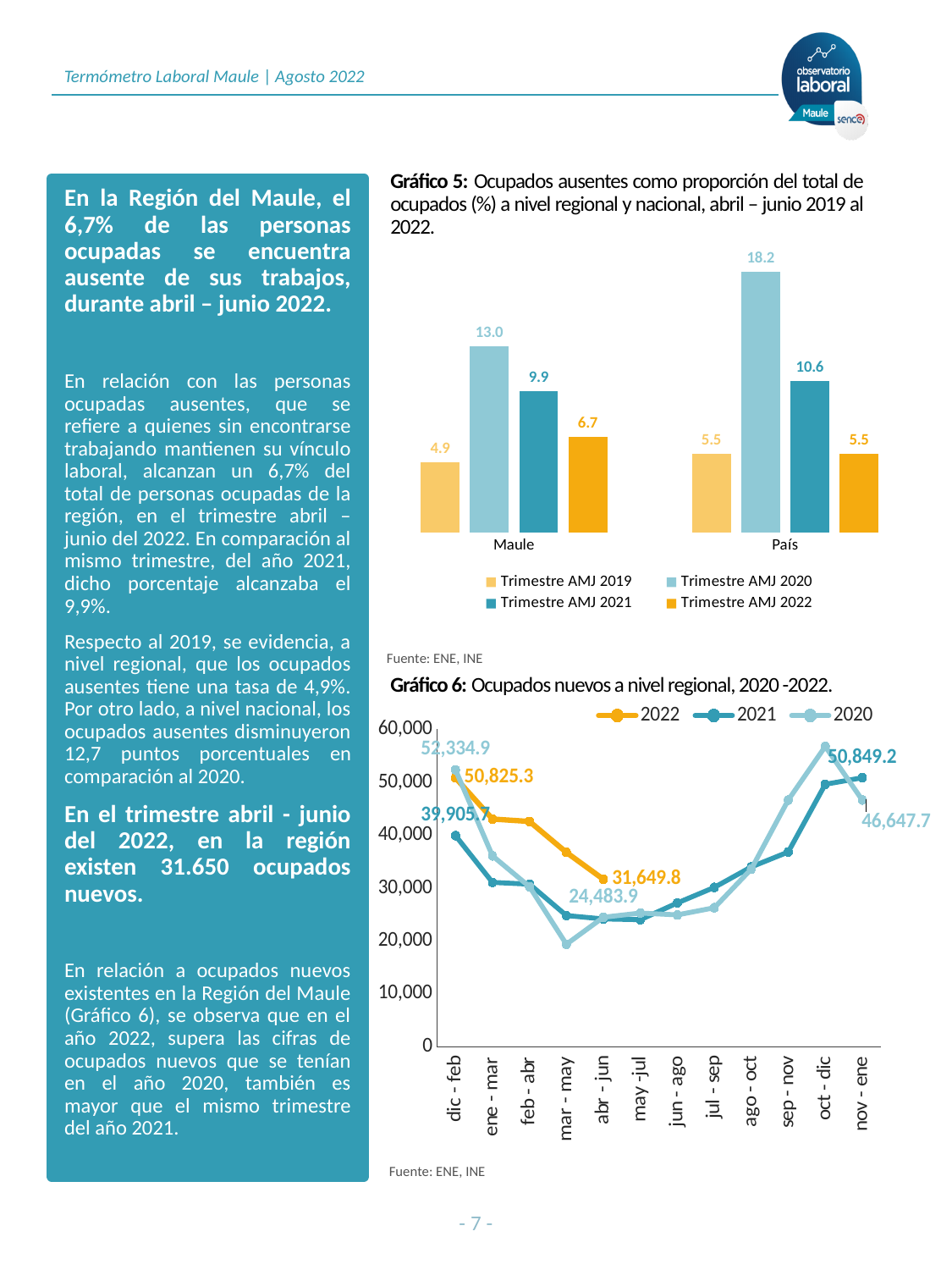
In Gráfico 5, which series has the highest value for Maule? Trimestre AMJ 2020 In Gráfico 5, what is the value for Maule in Trimestre AMJ 2022? 6.7 In Gráfico 6, how many periods are shown on the x axis? 12 In Gráfico 5, what is the value for País in Trimestre AMJ 2020? 18.2 What kind of chart is Gráfico 5? Bar chart In Gráfico 5, which series has the lowest value for Maule? Trimestre AMJ 2019 In Gráfico 6, what is the value of the 2020 series at dic - feb? 52,334.9 In Gráfico 5, what is the difference between the Maule values for Trimestre AMJ 2020 and Trimestre AMJ 2021? 3.1 In Gráfico 6, what is the value of the 2022 series at abr - jun? 31,649.8 In Gráfico 6, is the value of the 2021 series at mar - may greater or less than 30,000? less In Gráfico 5, how many series does the legend list? 4 In Gráfico 5, which is larger: the Trimestre AMJ 2021 value for Maule or for País? País